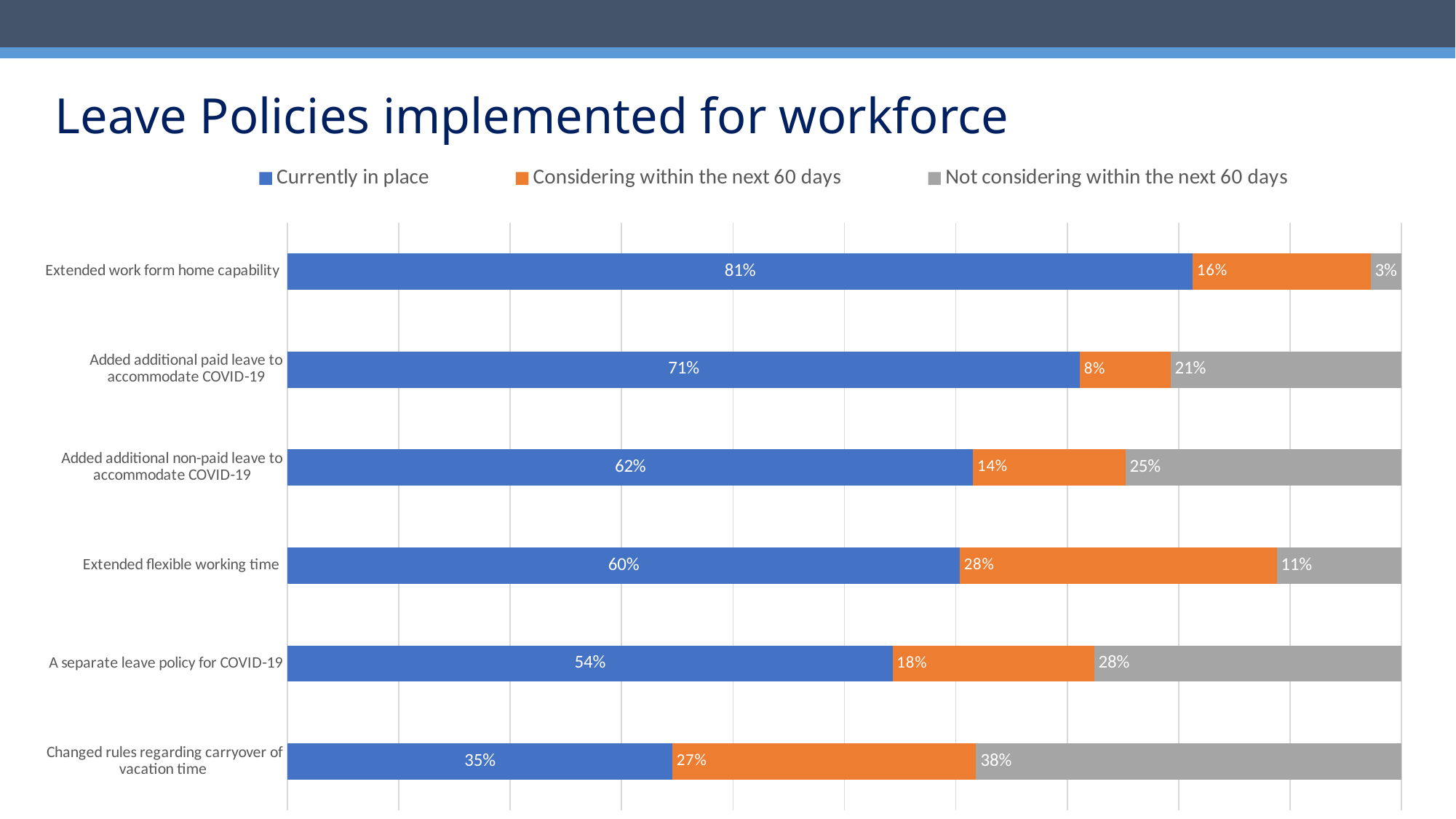
What is the 'Considering within the next 60 days' value for 'Extended flexible working time'? 28% Which colour represents 'Considering within the next 60 days' in the chart? Orange Which policy has the highest 'Currently in place' percentage? Extended work form home capability What is the difference between the 'Currently in place' values for 'Added additional paid leave to accommodate COVID-19' and 'A separate leave policy for COVID-19'? 17% Which is larger: the 'Not considering within the next 60 days' value for 'A separate leave policy for COVID-19' or for 'Added additional non-paid leave to accommodate COVID-19'? A separate leave policy for COVID-19 Which policy has the lowest 'Currently in place' percentage? Changed rules regarding carryover of vacation time How many leave policies are shown on the chart? 6 What percentage of respondents currently have extended work from home capability in place? 81% How many series does the legend list? 3 What kind of chart is shown on the slide? Stacked bar chart What is the total of the stacked bar for 'Extended work form home capability'? 100% What is the 'Not considering within the next 60 days' value for 'Changed rules regarding carryover of vacation time'? 38%